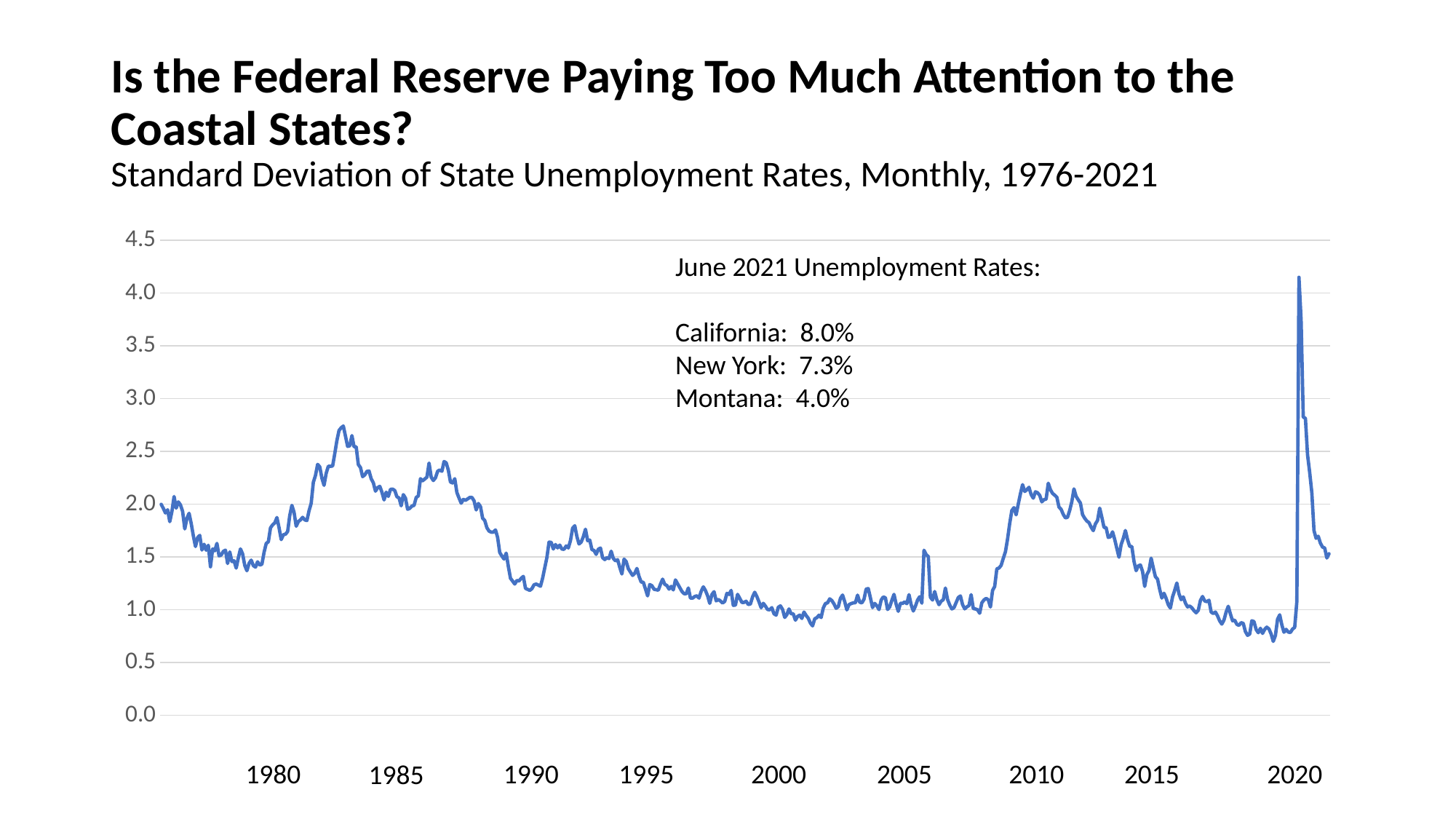
According to the annotation on the chart, what was California's unemployment rate in June 2021? 8.0% What kind of chart is shown on the slide? line chart Is the value of the line in 2019 greater or less than 1.0? less What is the subtitle describing the data plotted on the chart? Standard Deviation of State Unemployment Rates, Monthly, 1976-2021 Is the value of the line at its 1983 peak greater or less than 2.5? greater In which year does the standard deviation of state unemployment rates reach its highest peak? 2020 Does the line rise or fall between 2008 and 2010? rise Is the value of the line around 2010 greater or less than 1.5? greater How many lines (data series) are plotted on the chart? 1 Does the line generally rise or fall between 2011 and 2019? fall